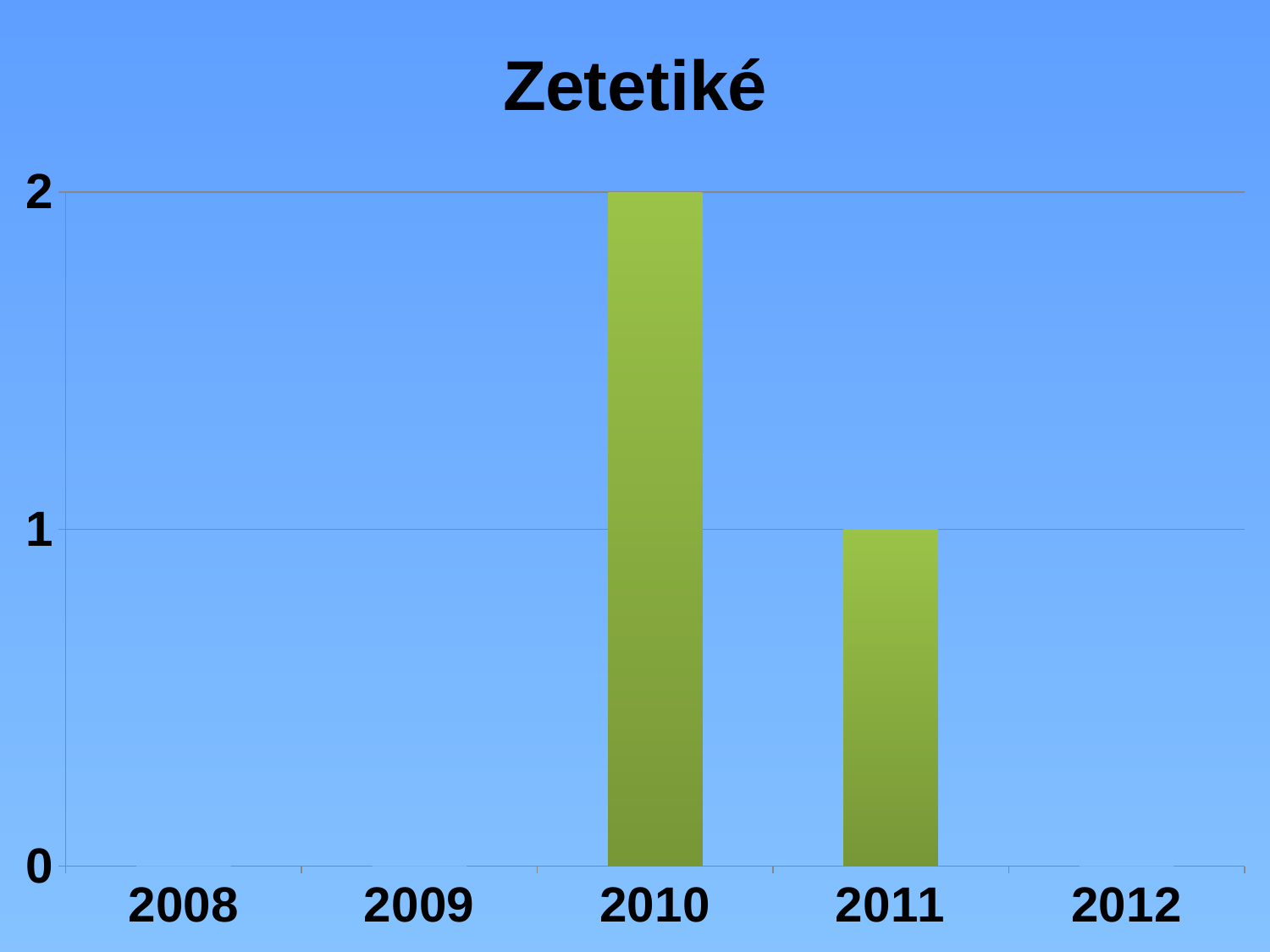
How many years have a visible bar? 2 What is the value for 2008? 0 What is the difference between the values for 2010 and 2011? 1 What is the title of the chart? Zetetiké What is the value for 2011? 1 Does the value rise or fall from 2010 to 2011? fall How many years are shown on the x axis? 5 Which is larger, the value for 2010 or the value for 2011? 2010 What kind of chart is shown on the slide? bar chart Which year has the highest value? 2010 Is the value for 2010 greater or less than 1? greater What is the value for 2010? 2